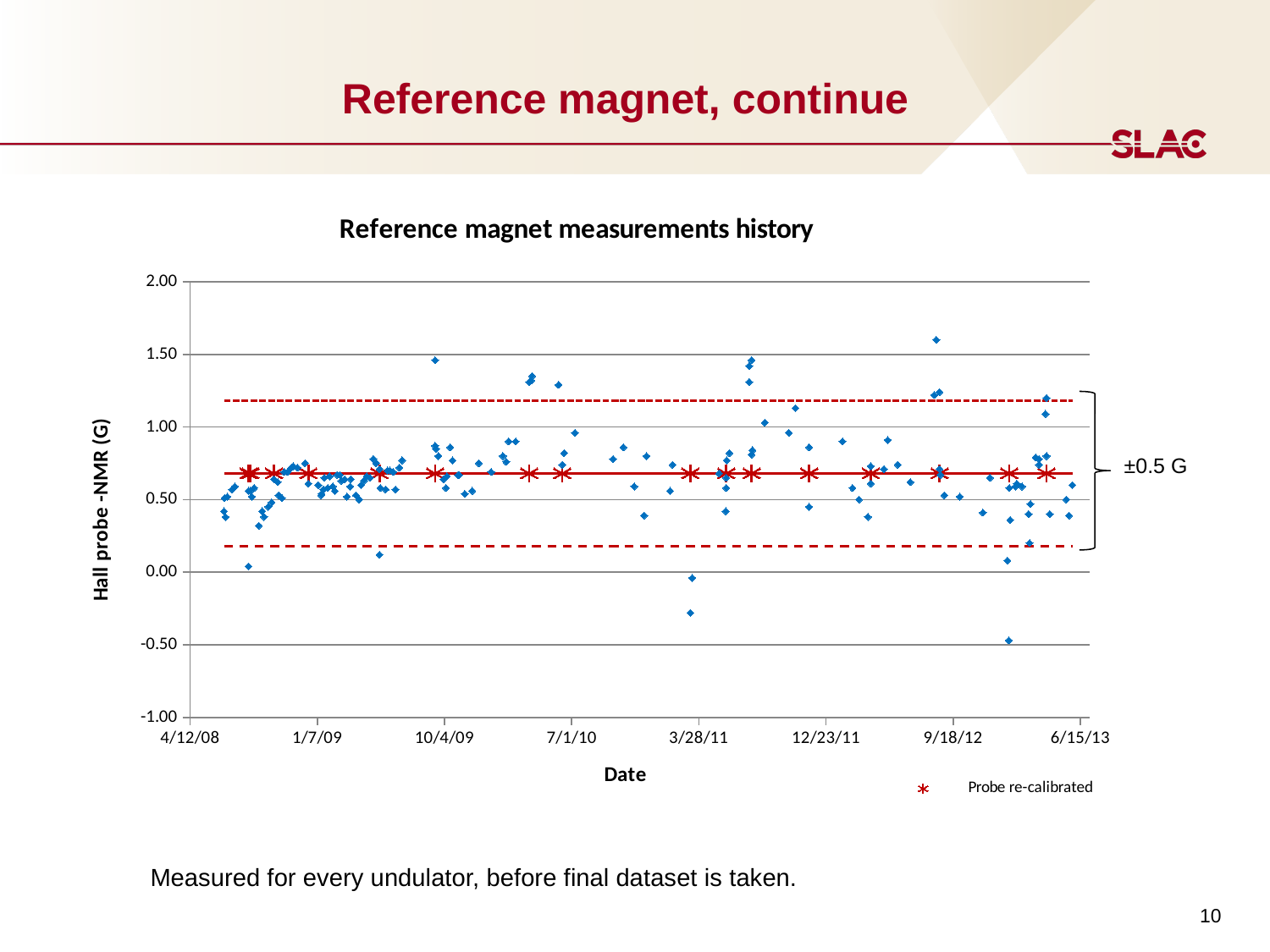
What does the red asterisk marker in the legend represent? Probe re-calibrated What is the label of the vertical axis of the chart? Hall probe -NMR (G) Is the upper dashed red line on the chart greater or less than 1.00 on the vertical axis? greater What is the title of the chart? Reference magnet measurements history Is the highest plotted data point on the chart greater or less than 1.50? greater Is the lowest plotted data point on the chart greater or less than 0.00? less What tolerance band is annotated next to the dashed lines on the chart? ±0.5 G What is the first date label shown on the horizontal axis of the chart? 4/12/08 Near which x-axis date label does the highest plotted point on the chart occur? 9/18/12 What is the maximum value shown on the vertical axis of the chart? 2.00 What kind of chart is shown on the slide? Scatter chart